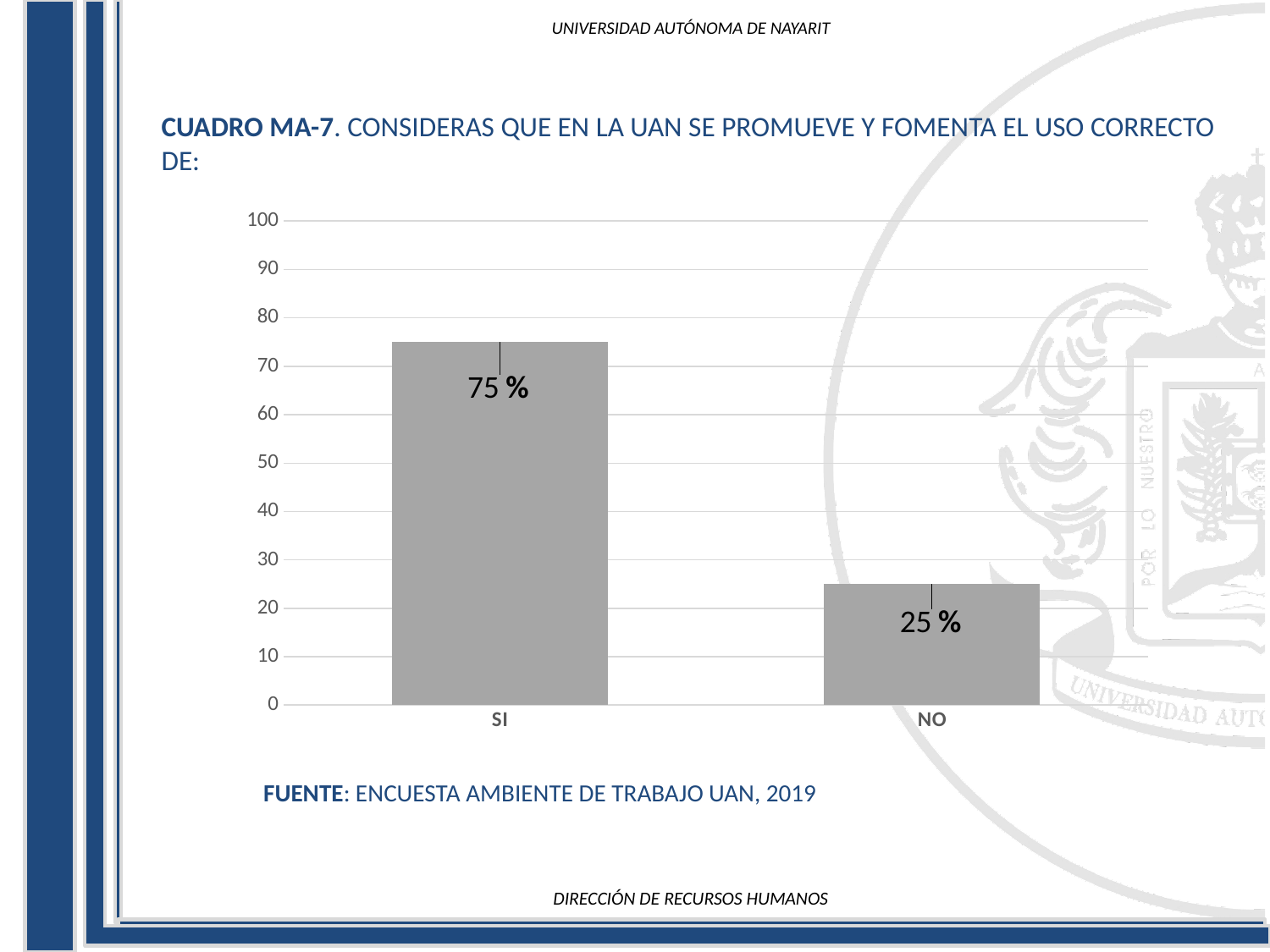
How many categories are shown on the x axis? 2 What is the value for SI? 75 % Is the value for NO greater or less than 30? less What is the source cited below the chart? ENCUESTA AMBIENTE DE TRABAJO UAN, 2019 Which category has the highest value? SI What is the difference between the values for SI and NO? 50 % What is the maximum value shown on the y axis? 100 Which is larger, the value for SI or the value for NO? SI What kind of chart is shown on the slide? bar chart Is the value for SI greater or less than 70? greater What is the value for NO? 25 % Which category has the lowest value? NO